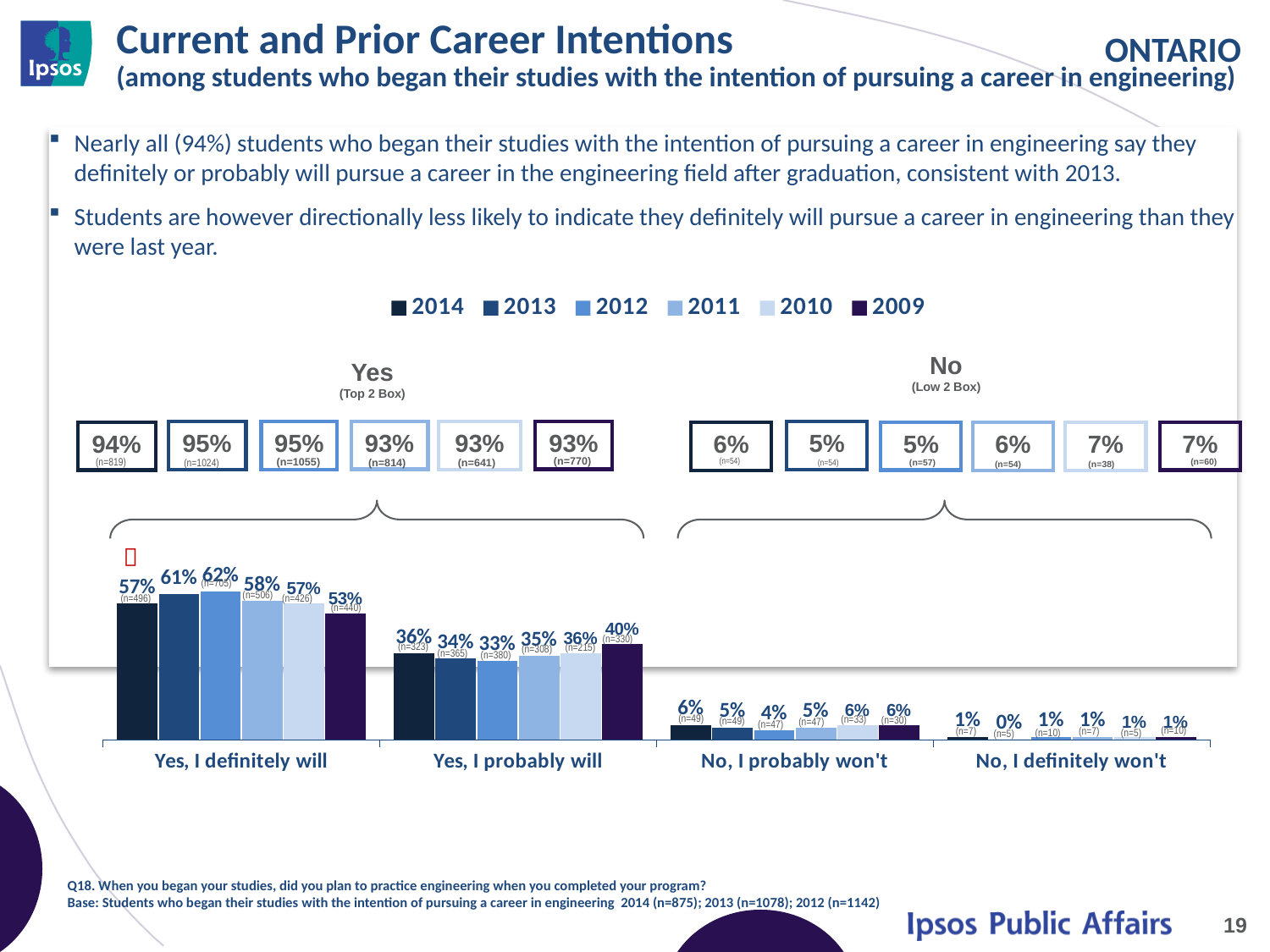
What is the value for 2009 in the "Yes, I probably will" category? 40% What kind of chart is shown on the slide? Bar chart Which is larger in the "Yes, I probably will" category: the 2009 value or the 2012 value? 2009 What is the value for 2014 in the "Yes, I definitely will" category? 57% Which year has the highest value in the "Yes, I definitely will" category? 2012 What is the Top 2 Box (Yes) percentage shown for 2014? 94% Which year has the lowest value in the "Yes, I definitely will" category? 2009 What is the difference between the 2013 and 2014 values in the "Yes, I definitely will" category? 4% What is the value for 2012 in the "No, I probably won't" category? 4% What is the value for 2013 in the "No, I definitely won't" category? 0% How many categories are shown on the x axis? 4 How many series does the legend list? 6